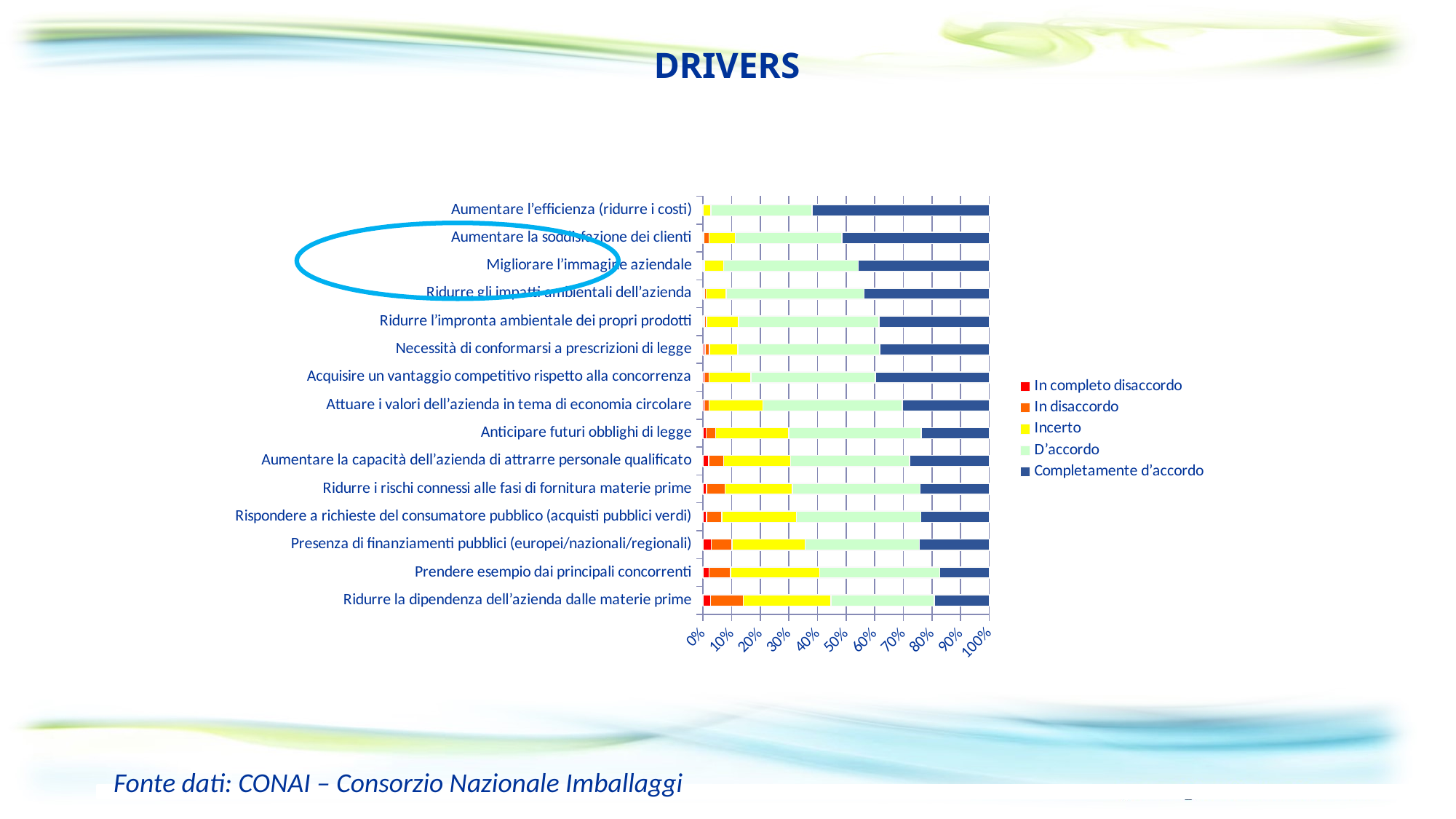
Which has a larger 'Completamente d'accordo' share: 'Aumentare l'efficienza (ridurre i costi)' or 'Prendere esempio dai principali concorrenti'? Aumentare l'efficienza (ridurre i costi) Is the 'Incerto' share for 'Ridurre la dipendenza dell'azienda dalle materie prime' greater or less than 20%? greater Is the 'Completamente d'accordo' share for 'Migliorare l'immagine aziendale' greater or less than 50%? less Is the 'D'accordo' share for 'Aumentare l'efficienza (ridurre i costi)' greater or less than 30%? greater Which category has the largest 'Completamente d'accordo' share? Aumentare l'efficienza (ridurre i costi) What is the title of the slide containing the chart? DRIVERS How many categories (drivers) are listed on the chart? 15 What kind of chart is shown on the slide? Stacked bar chart How many series does the legend list? 5 Which colour represents the 'Incerto' series in the chart? Yellow